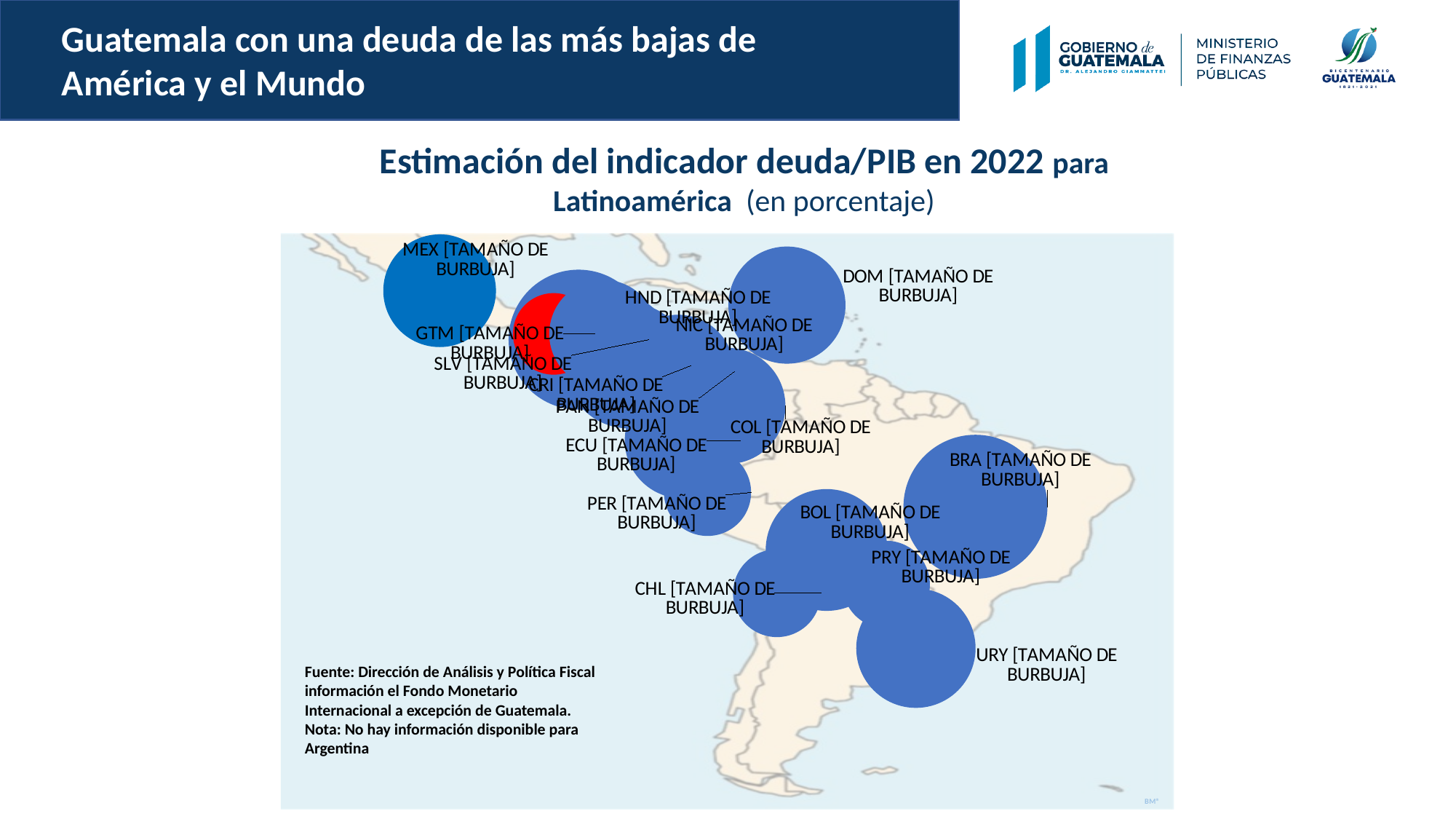
Which bubble is larger, URY or GTM? URY What is the title of the chart? Estimación del indicador deuda/PIB en 2022 para Latinoamérica (en porcentaje) How many countries are labelled with bubbles on the chart? 16 What kind of chart is shown on the slide? Bubble chart Which country's bubble is coloured red on the chart? GTM Which bubble is larger, BRA or GTM? BRA Which bubble is larger, MEX or GTM? MEX